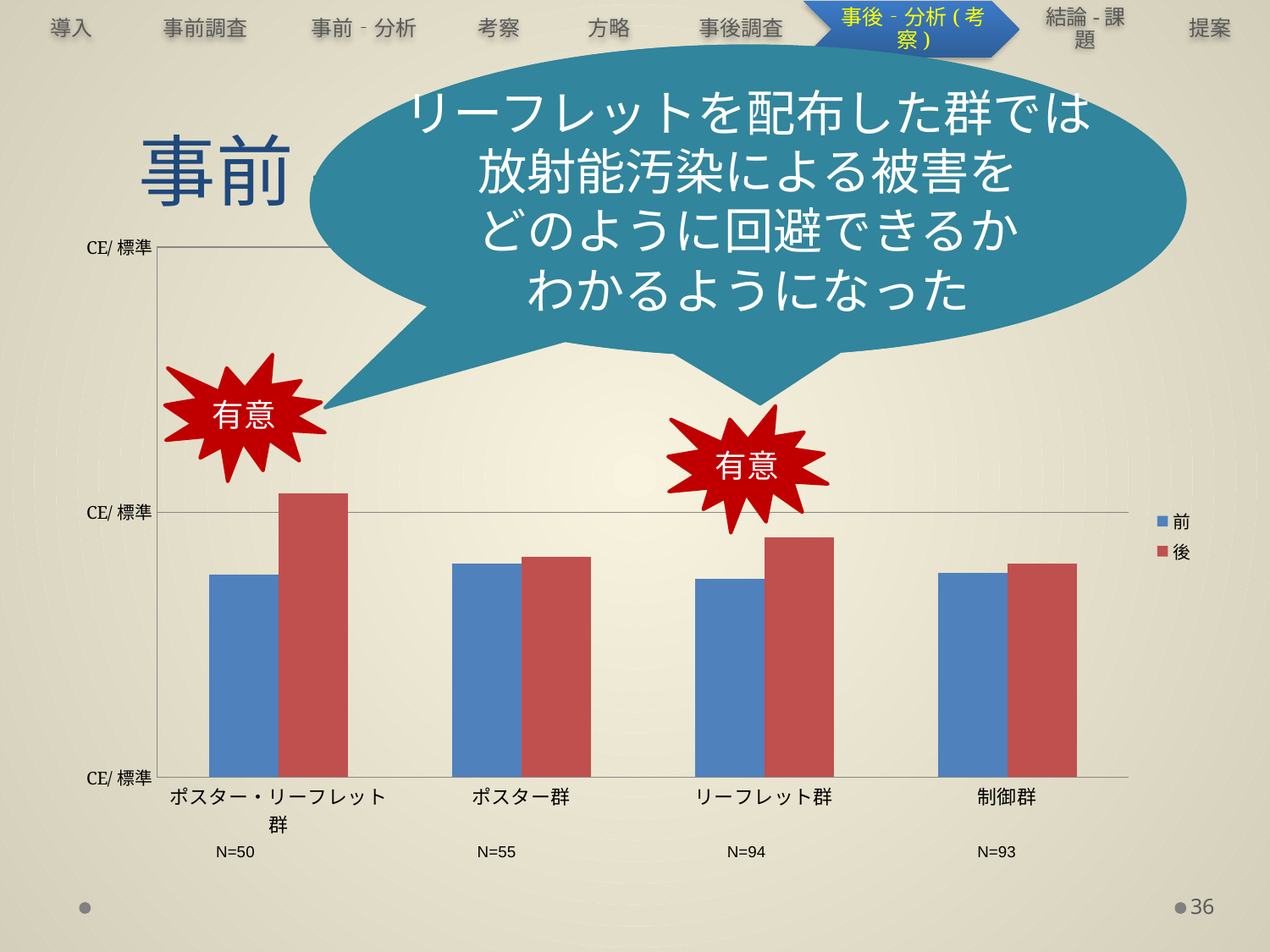
Which is larger, the 後 bar for ポスター・リーフレット群 or the 前 bar for ポスター群? ポスター・リーフレット群 後 How many categories (groups) are shown on the x axis of the chart? 4 Which is larger, the 後 bar for ポスター・リーフレット群 or the 後 bar for リーフレット群? ポスター・リーフレット群 How many series does the chart's legend list? 2 For ポスター・リーフレット群, which is larger, the 前 bar or the 後 bar? 後 What are the two series listed in the chart's legend? 前 and 後 Which colour represents the 後 series in the chart? red Which category has the highest 後 bar? ポスター・リーフレット群 What kind of chart is shown on the slide? bar chart Which category is labelled with the largest sample size (N) below the chart? リーフレット群